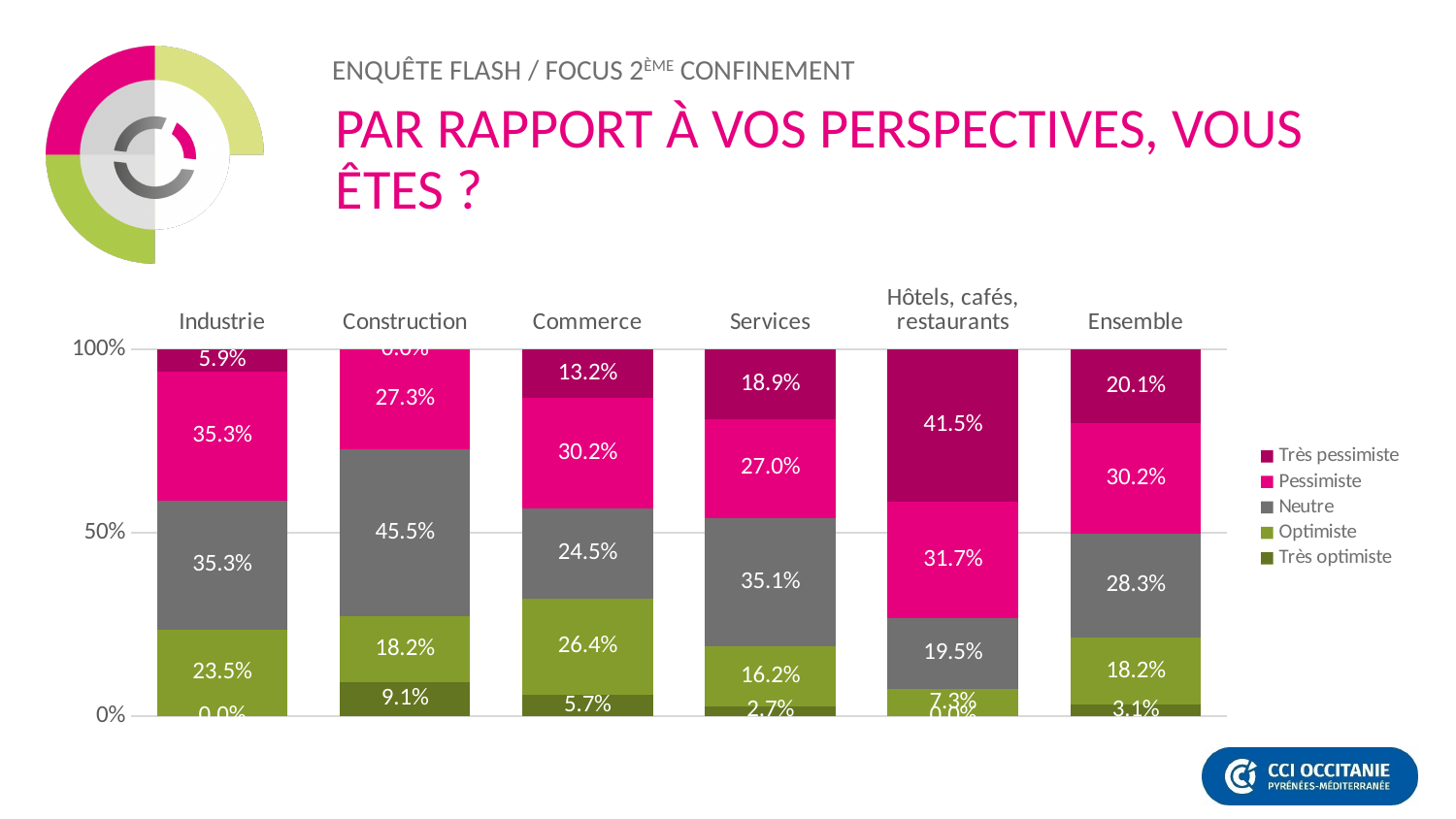
What is the difference between the 'Très pessimiste' values for Hôtels, cafés, restaurants and Services? 22.6% How many categories (sectors) are shown along the x axis? 6 What is the 'Très pessimiste' value for Hôtels, cafés, restaurants? 41.5% What is the 'Optimiste' value for Commerce? 26.4% What is the 'Pessimiste' value for Ensemble? 30.2% Which series is shown in grey in the legend? Neutre What is the 'Neutre' value for Construction? 45.5% What kind of chart is shown on the slide? Stacked bar chart Which is larger, the 'Optimiste' value for Industrie or for Services? Industrie Which category has the highest 'Neutre' share? Construction How many series does the legend list? 5 Which category has the highest 'Très pessimiste' share? Hôtels, cafés, restaurants